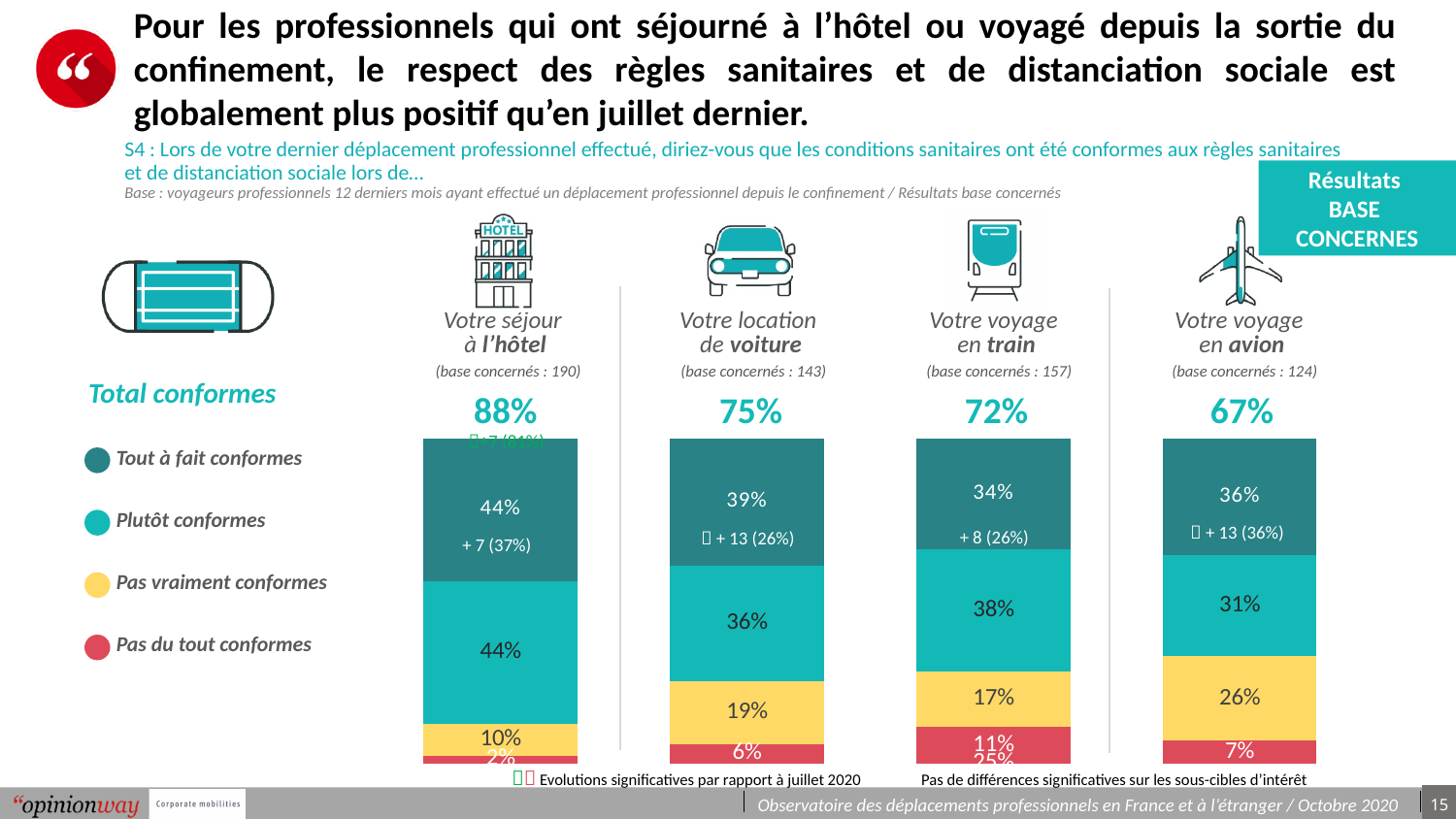
What is the difference in 'Total conformes' between 'Votre séjour à l'hôtel' and 'Votre voyage en avion'? 21 points What is the 'Total conformes' value for 'Votre séjour à l'hôtel'? 88% What percentage of respondents answered 'Pas vraiment conformes' for 'Votre voyage en train'? 17% How many response categories does the legend list? 4 What percentage of respondents answered 'Tout à fait conformes' for 'Votre location de voiture'? 39% What is the 'Total conformes' value for 'Votre voyage en avion'? 67% Which travel category has the lowest 'Total conformes' value? Votre voyage en avion Which has a larger 'Pas du tout conformes' share: 'Votre voyage en train' or 'Votre location de voiture'? Votre voyage en train How many travel categories are shown as stacked bars? 4 What kind of chart is used to show the responses? Stacked bar chart Which travel category has the highest 'Total conformes' value? Votre séjour à l'hôtel What percentage of respondents answered 'Pas du tout conformes' for 'Votre séjour à l'hôtel'? 2%